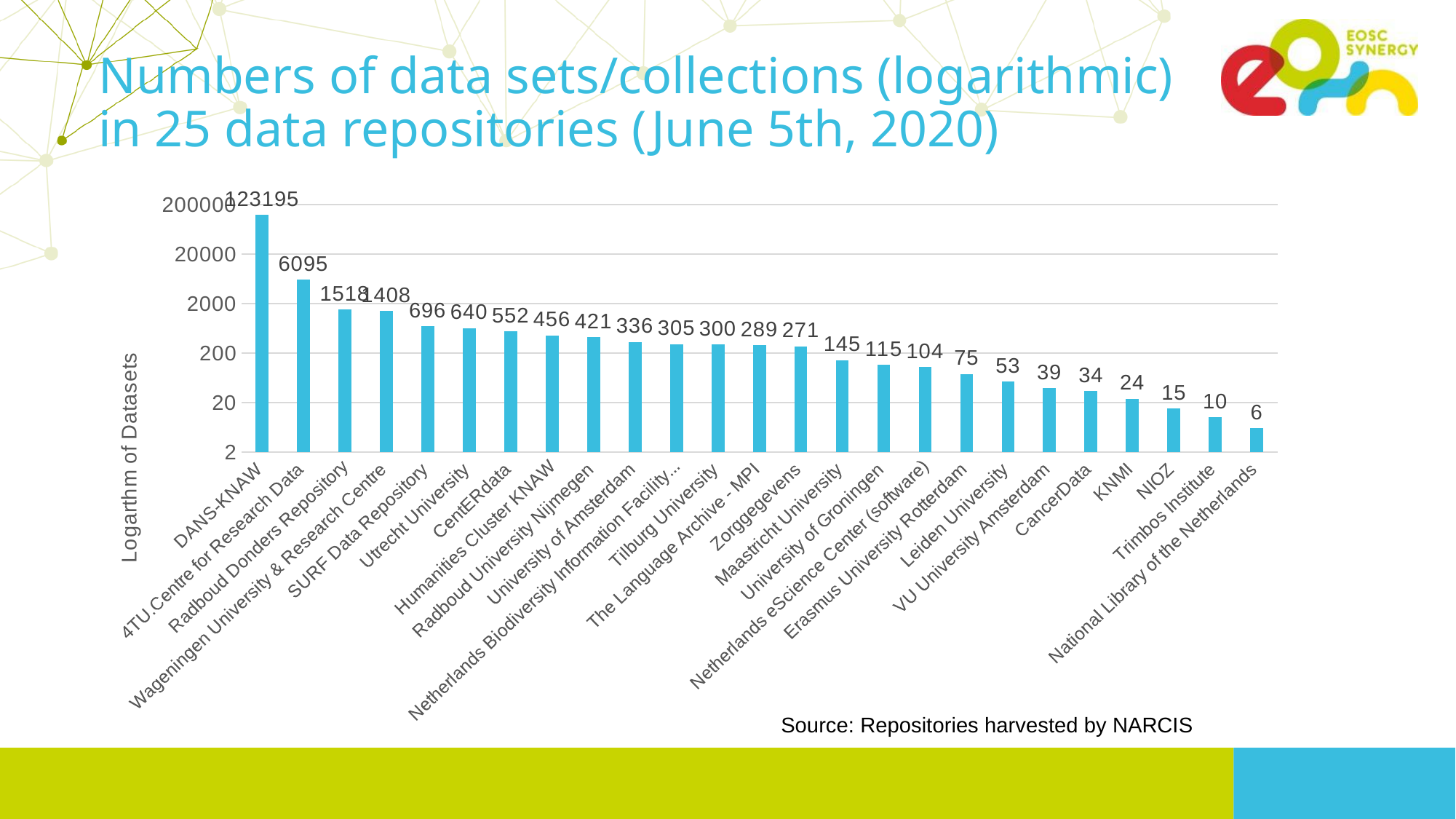
What is the number of data sets for Utrecht University? 640 Which repository has the highest number of data sets? DANS-KNAW What kind of chart is shown on the slide? Bar chart Do the values rise or fall from left to right along the x axis? Fall How many data repositories are plotted in the chart? 25 What is the number of data sets for 4TU.Centre for Research Data? 6095 What is the difference between the values for Leiden University and VU University Amsterdam? 14 What is the label of the vertical axis? Logarthm of Datasets Which has more data sets, Maastricht University or University of Groningen? Maastricht University What is the difference between the values for Radboud Donders Repository and Wageningen University & Research Centre? 110 What is the number of data sets for KNMI? 24 Which repository has the lowest number of data sets? National Library of the Netherlands